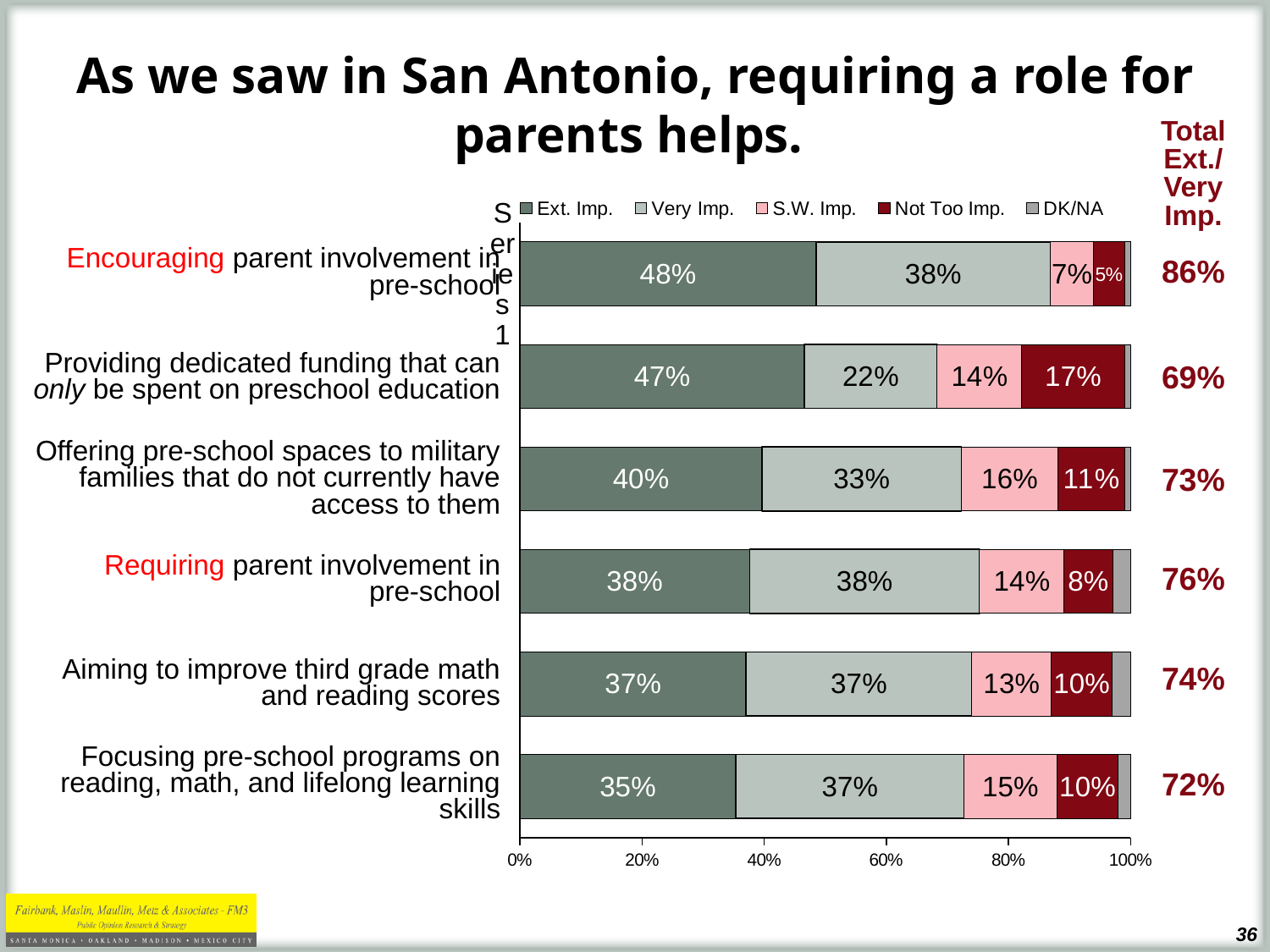
How many categories are shown in the chart? 6 What is the combined Ext. Imp. and Very Imp. total for 'Providing dedicated funding that can only be spent on preschool education'? 69% What is the difference in Ext. Imp. values between 'Encouraging parent involvement in pre-school' and 'Requiring parent involvement in pre-school'? 10 percentage points How many series does the legend list? 5 Which category has the highest Not Too Imp. value? Providing dedicated funding that can only be spent on preschool education What kind of chart is shown on the slide? Stacked bar chart Which has a larger S.W. Imp. value: 'Offering pre-school spaces to military families' or 'Aiming to improve third grade math and reading scores'? Offering pre-school spaces to military families What percentage of respondents rated 'Providing dedicated funding that can only be spent on preschool education' as Ext. Imp.? 47% Which category has the highest Ext. Imp. value? Encouraging parent involvement in pre-school Which category has the lowest Ext. Imp. value? Focusing pre-school programs on reading, math, and lifelong learning skills What is the Very Imp. value for 'Offering pre-school spaces to military families that do not currently have access to them'? 33% What is the Not Too Imp. value for 'Requiring parent involvement in pre-school'? 8%